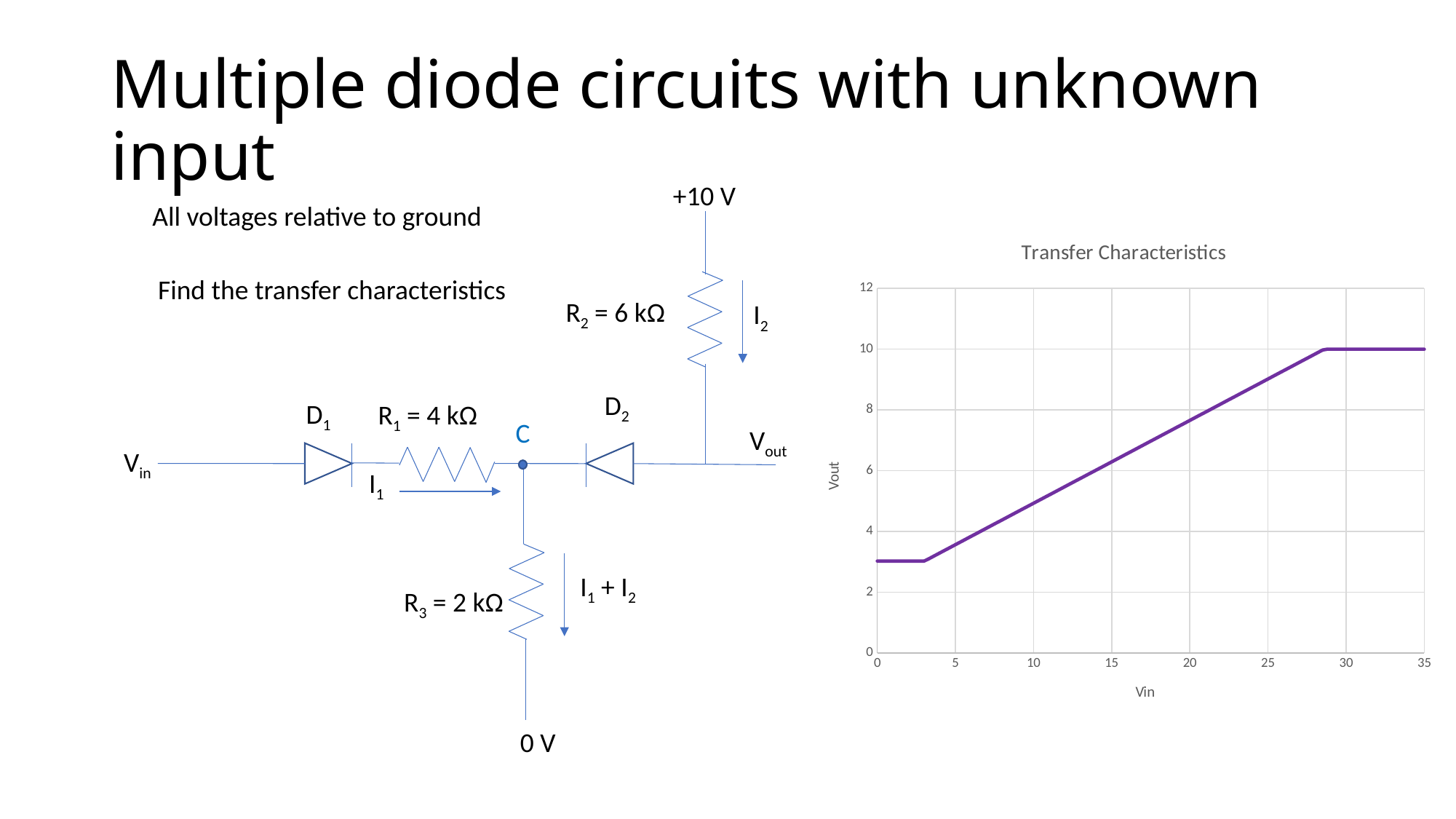
In the Transfer Characteristics chart, is the value of Vout at Vin = 25 greater or less than 8? greater What are the x-axis and y-axis labels of the Transfer Characteristics chart? Vin and Vout In the Transfer Characteristics chart, which is larger: Vout at Vin = 25 or Vout at Vin = 10? Vout at Vin = 25 In the Transfer Characteristics chart, is the value of Vout at Vin = 20 greater or less than 6? greater In the Transfer Characteristics chart, what is the value of Vout when Vin is 35? 10 In the Transfer Characteristics chart, what is the highest value Vout reaches? 10 What kind of chart is the Transfer Characteristics chart? line chart In the Transfer Characteristics chart, is the value of Vout at Vin = 0 greater or less than 4? less In the Transfer Characteristics chart, does Vout generally rise or fall as Vin increases from 0 to 35? rise What is the title of the chart on the slide? Transfer Characteristics In the Transfer Characteristics chart, what is the value of Vout when Vin is 30? 10